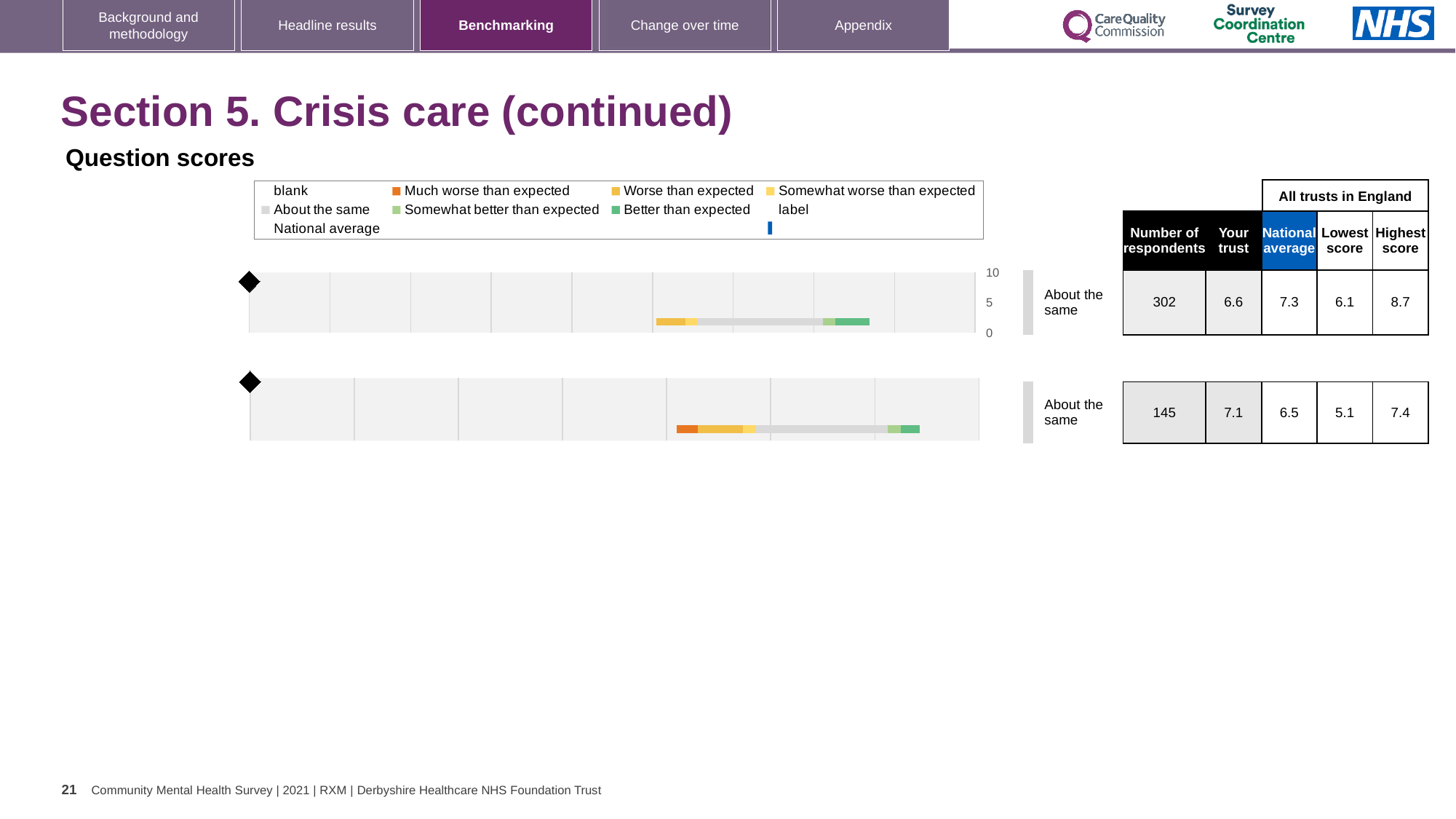
What is the difference in the number of respondents between the top chart (302) and the bottom chart (145)? 157 For the bottom chart, which is larger: the 'Your trust' score or the national average? Your trust For the top chart, what is the national average score? 7.3 What kind of chart is used to show the benchmarking results on this slide? bar chart How many benchmarking charts are shown on the slide? 2 For the top chart, which is larger: the 'Your trust' score or the national average? National average For the bottom chart, what is the 'Your trust' score? 7.1 For the top chart, how many respondents are listed? 302 What benchmark category label is shown next to both charts? About the same For the top chart, what is the difference between the highest score (8.7) and the lowest score (6.1)? 2.6 For the bottom chart, what is the highest score among all trusts in England? 7.4 For the top chart, what is the 'Your trust' score shown in the table? 6.6